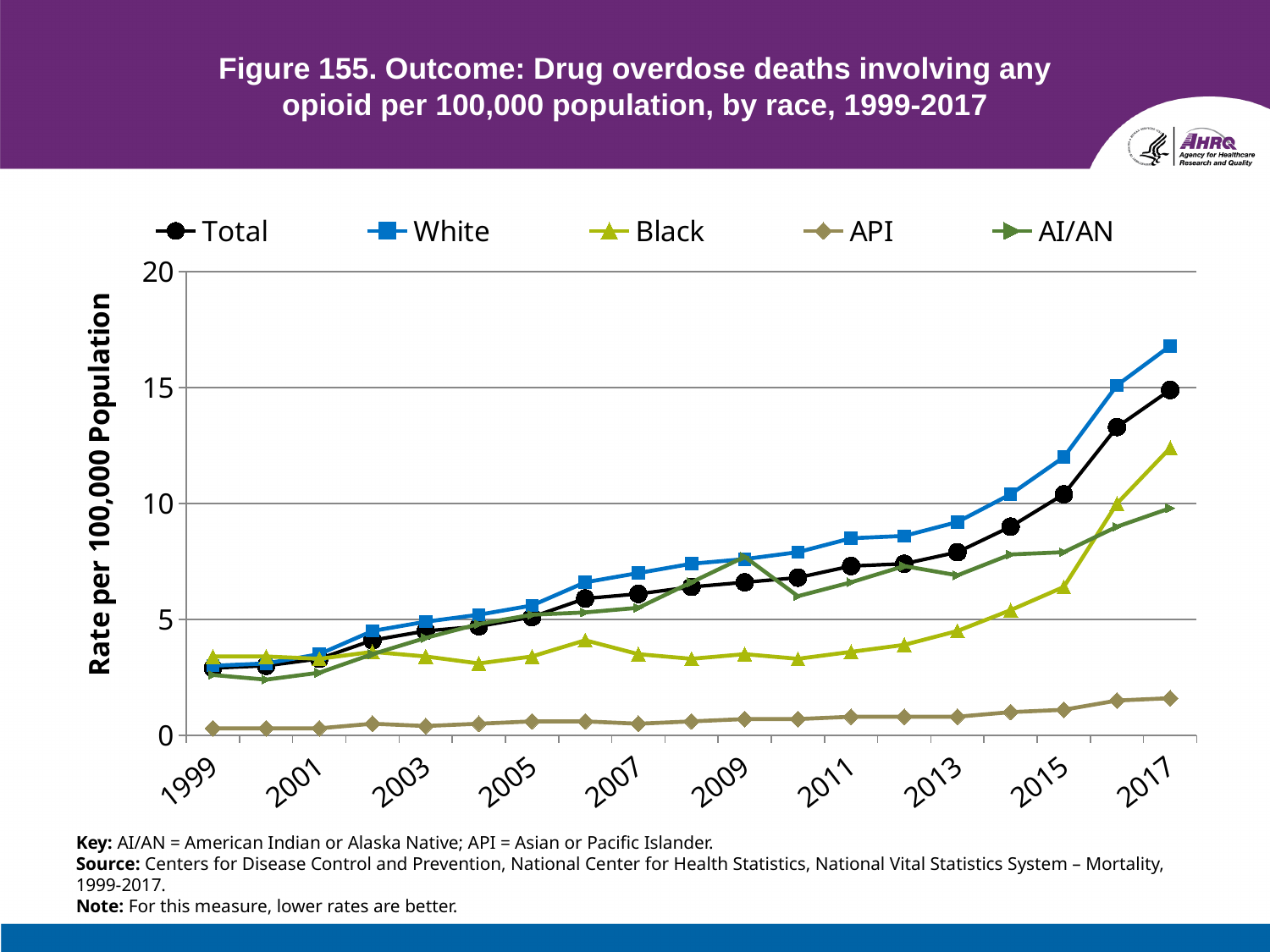
How many series does the legend list? 5 What kind of chart is shown on the slide? Line chart In 2013, which is larger, the rate for AI/AN or the rate for Black? AI/AN Does the rate for White rise or fall from 1999 to 2017? Rise Is the value for Black in 1999 greater or less than 5? less How many years (data points per series) are plotted along the x axis? 19 Which race group has the highest rate in 2017? White Is the value for White in 2017 greater or less than 15? greater Which race group has the lowest rate in 2017? API Is the value for Black in 2017 greater or less than 10? greater What is the label on the y axis? Rate per 100,000 Population